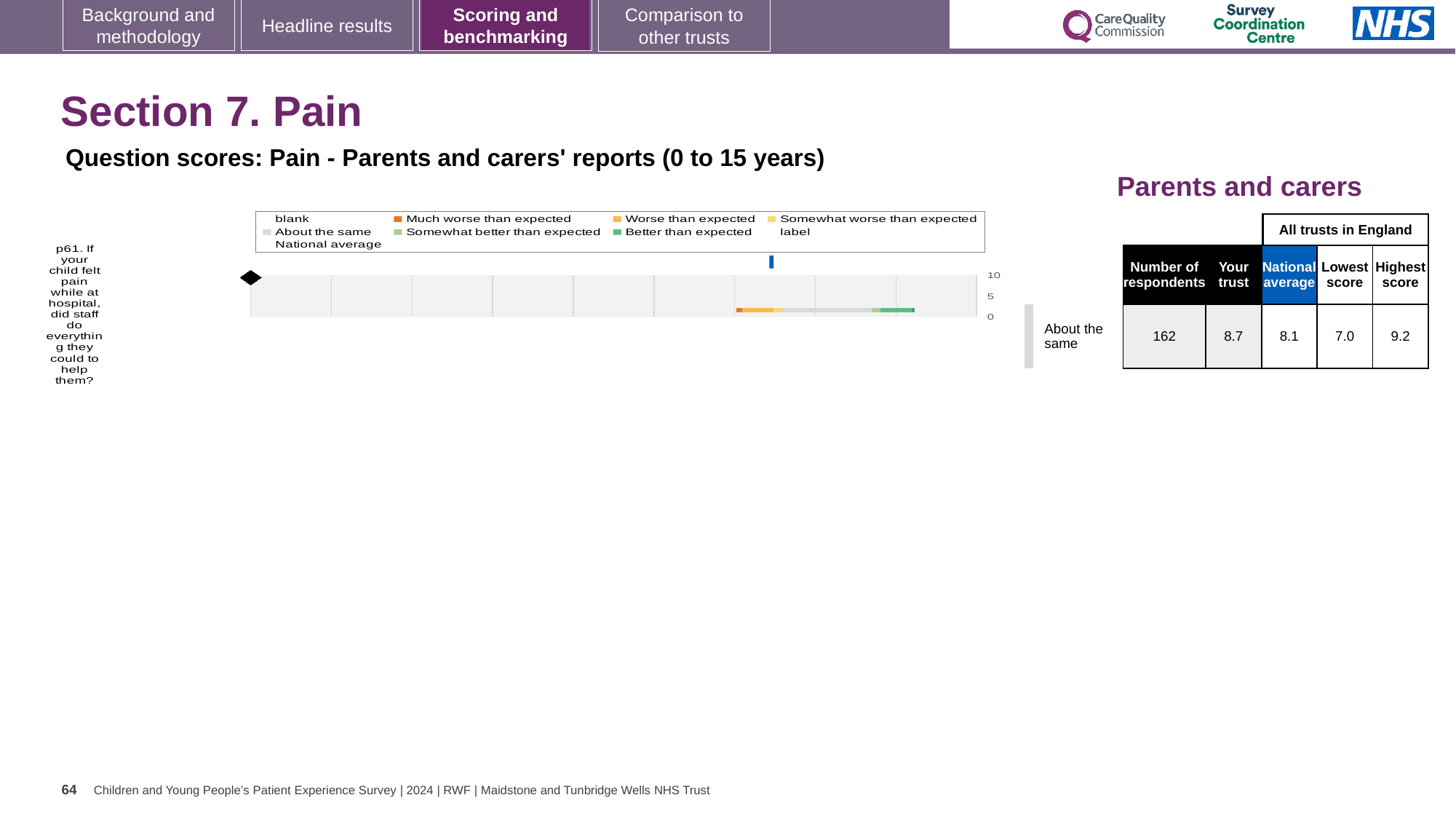
What is the highest value shown on the chart's score axis? 10 Which is larger for question p61: the 'Your trust' score or the national average? Your trust How many survey questions are plotted on the chart? 1 What is the highest score among all trusts in England for question p61? 9.2 What is the difference between the highest score and the lowest score for question p61? 2.2 By how much does the 'Your trust' score exceed the national average for question p61? 0.6 What is the 'Your trust' score for question p61 (did staff do everything they could to help with pain)? 8.7 How many respondents answered question p61? 162 What is the lowest score among all trusts in England for question p61? 7.0 What kind of chart is used to show the p61 pain question score? Bar chart What is the national average score for question p61? 8.1 What benchmark category is question p61 assigned to? About the same